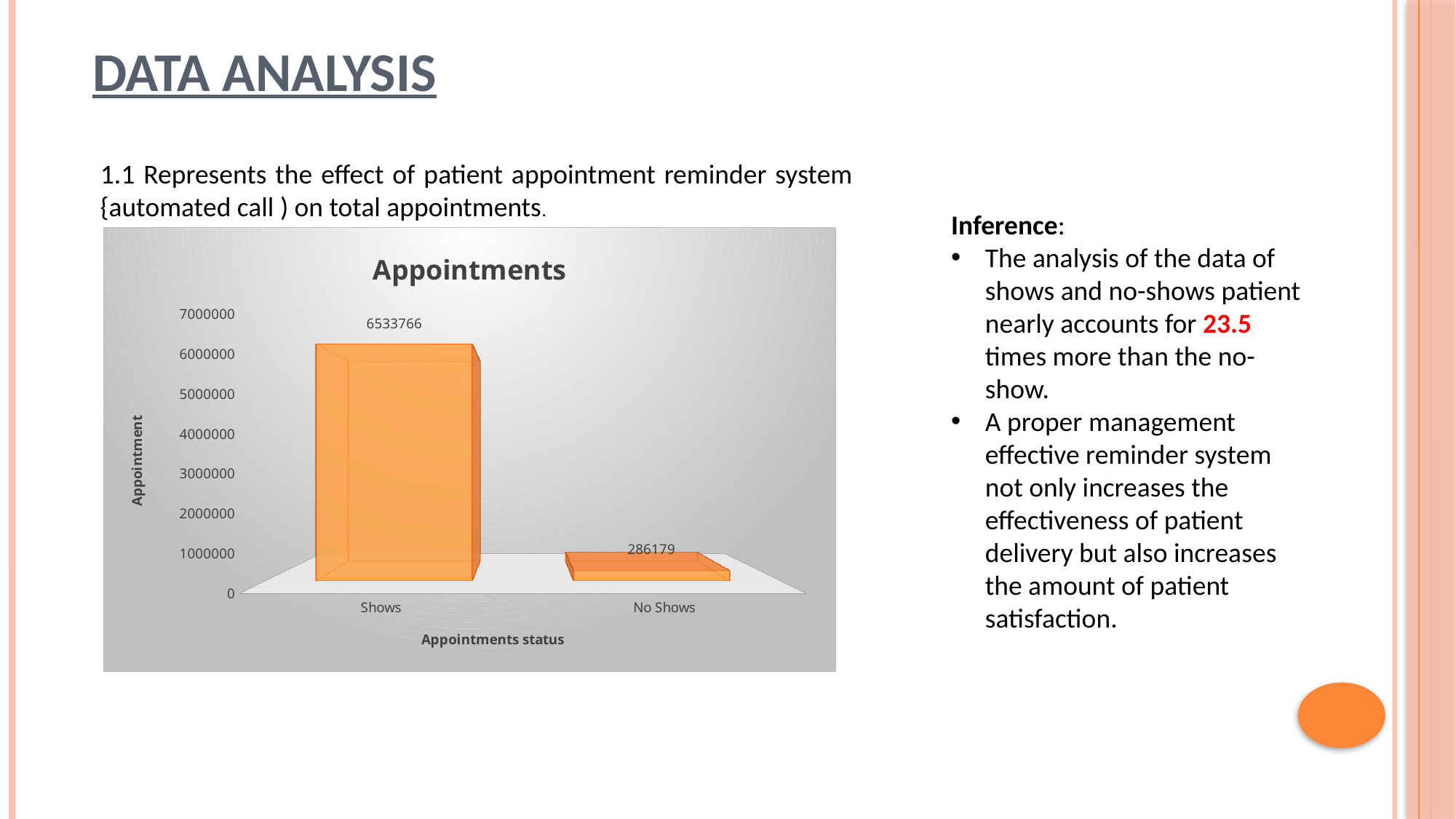
Is the value for Shows greater or less than 6000000? greater Is the value for No Shows greater or less than 1000000? less Which category has the highest value in the Appointments chart? Shows What is the value for Shows in the Appointments chart? 6533766 What kind of chart is the Appointments chart? bar chart How many categories are shown in the Appointments chart? 2 What is the title of the chart on the slide? Appointments What is the difference between the Shows and No Shows values in the Appointments chart? 6247587 Which category has the lowest value in the Appointments chart? No Shows Which is larger in the Appointments chart, Shows or No Shows? Shows What is the value for No Shows in the Appointments chart? 286179 What is the label of the x axis in the Appointments chart? Appointments status